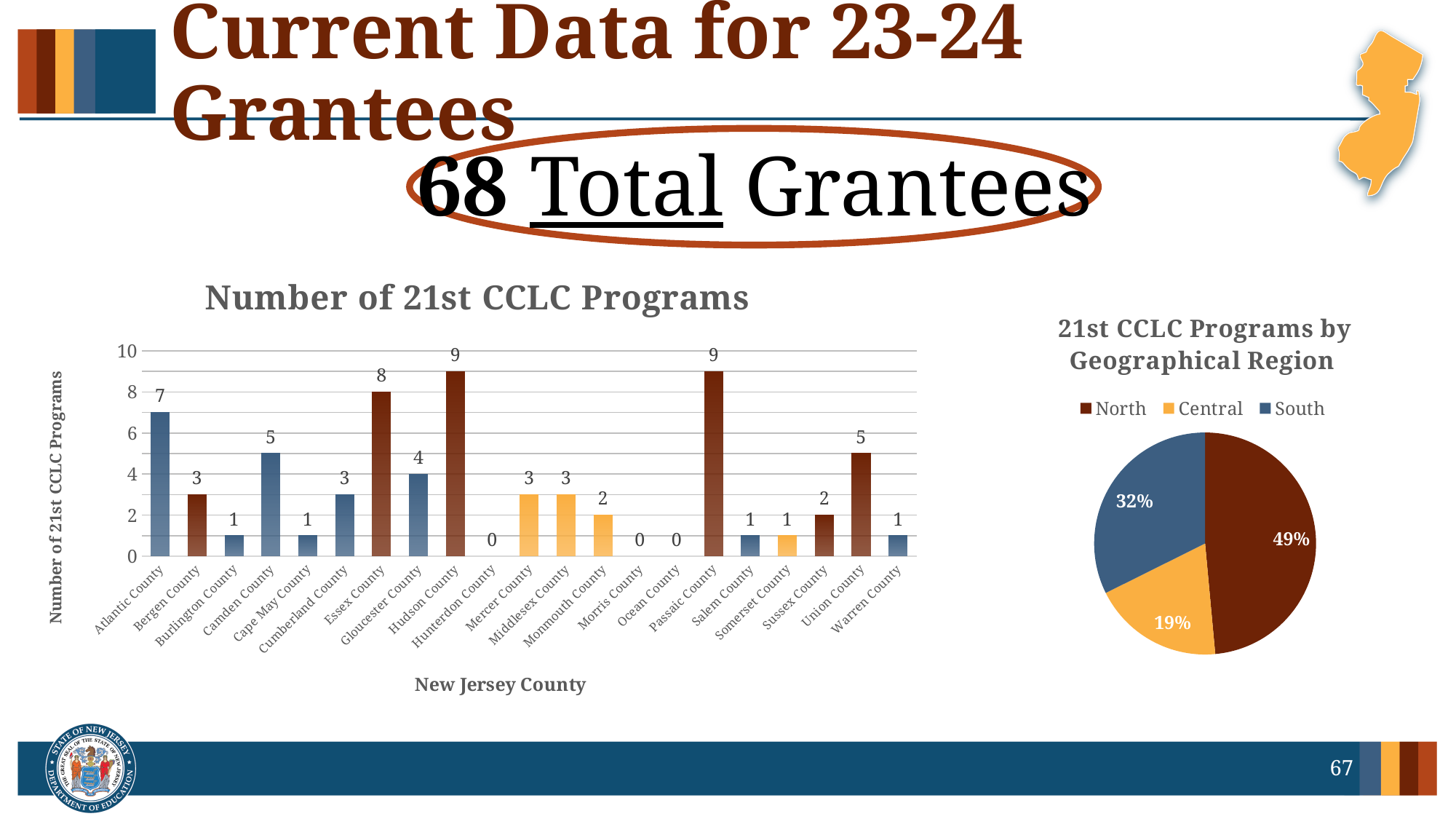
How many entries does the legend of the '21st CCLC Programs by Geographical Region' pie chart list? 3 In the '21st CCLC Programs by Geographical Region' pie chart, what share does the Central region have? 19% In the 'Number of 21st CCLC Programs' bar chart, which has more programs, Union County or Gloucester County? Union County In the '21st CCLC Programs by Geographical Region' pie chart, which region has the smallest share? Central In the 'Number of 21st CCLC Programs' bar chart, how many programs does Essex County have? 8 In the 'Number of 21st CCLC Programs' bar chart, how many counties are shown on the x axis? 21 In the 'Number of 21st CCLC Programs' bar chart, what is the value for Atlantic County? 7 What is the x-axis title of the 'Number of 21st CCLC Programs' bar chart? New Jersey County In the 'Number of 21st CCLC Programs' bar chart, what is the difference between Hudson County and Camden County? 4 In the 'Number of 21st CCLC Programs' bar chart, what is the value for Hunterdon County? 0 In the '21st CCLC Programs by Geographical Region' pie chart, what share does the North region have? 49% What type of chart is 'Number of 21st CCLC Programs'? Bar chart